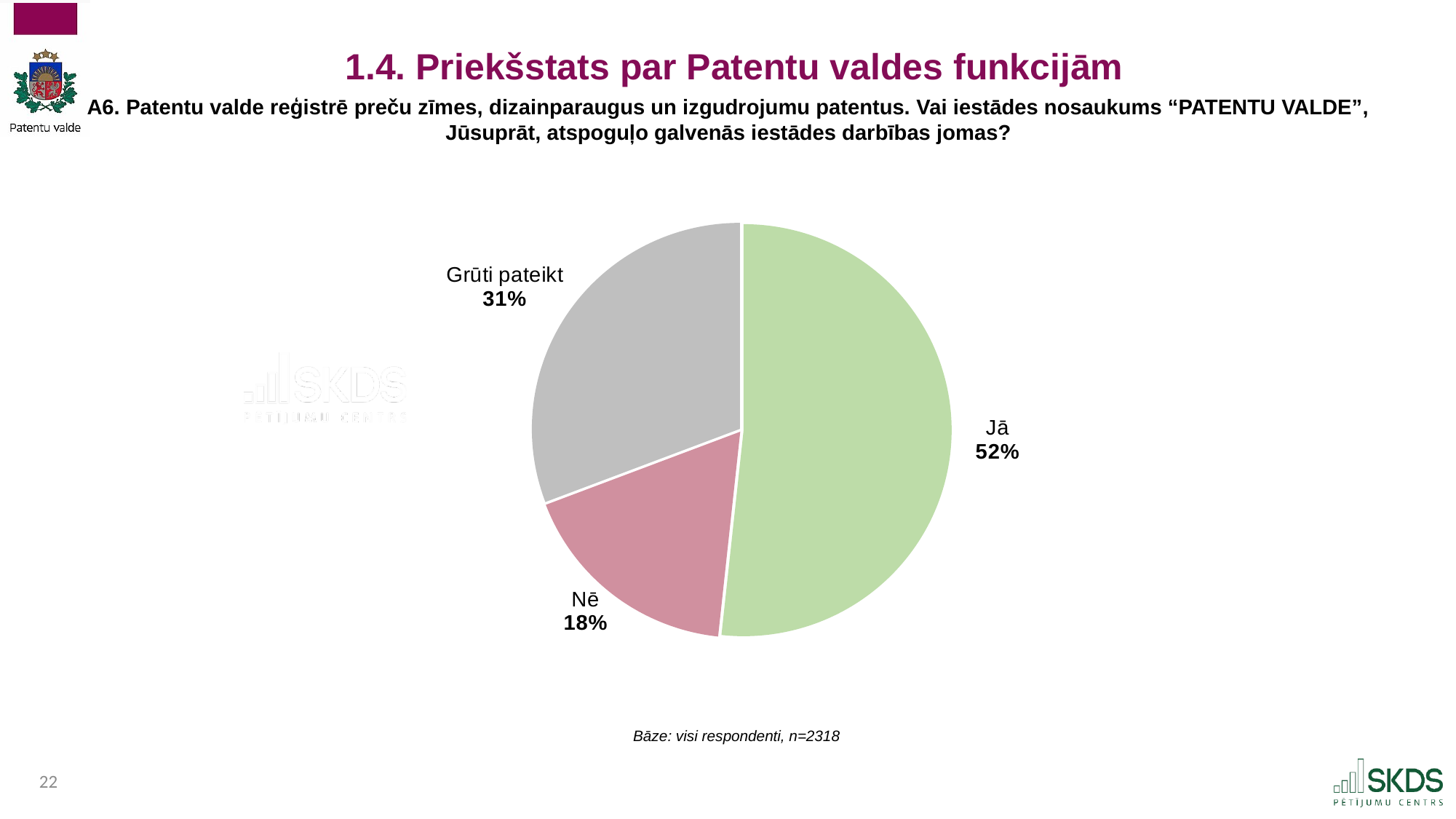
What percentage of respondents answered "Nē"? 18% What percentage of respondents answered "Grūti pateikt"? 31% Which response has the smallest share of the pie? Nē What is the base (n) stated below the chart? n=2318 How many slices does the pie chart have? 3 Which response has the largest share of the pie? Jā What kind of chart is shown on the slide? pie chart What is the difference in percentage points between "Jā" and "Nē"? 34 What is the difference in percentage points between "Grūti pateikt" and "Nē"? 13 What colour is the "Jā" slice? green What percentage of respondents answered "Jā"? 52% Which is larger, the share for "Grūti pateikt" or the share for "Nē"? Grūti pateikt